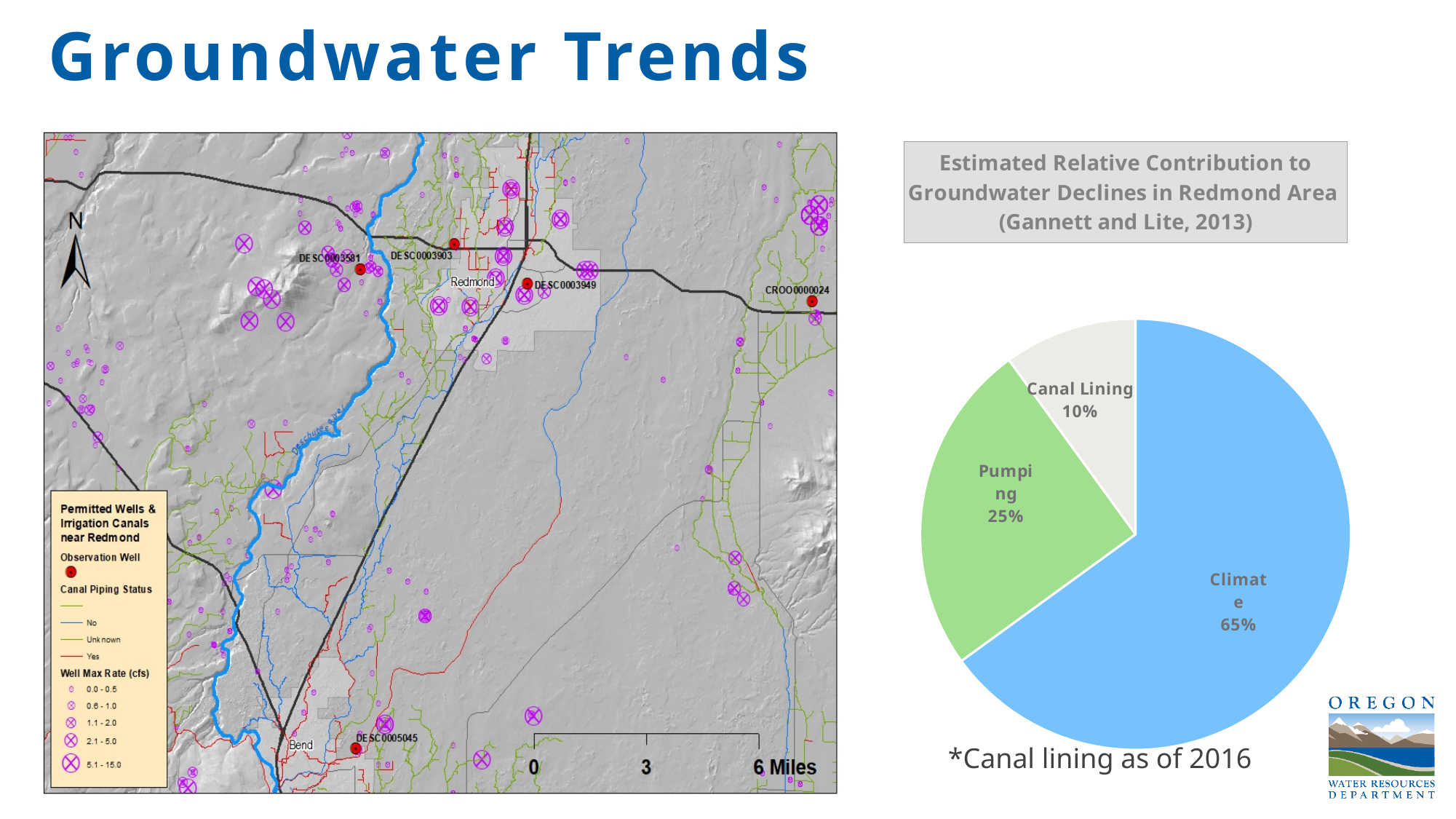
What is the estimated relative contribution of Pumping to groundwater declines in the Redmond area? 25% Which contributes more to groundwater declines according to the pie chart, Pumping or Canal Lining? Pumping Which factor has the largest share in the pie chart? Climate What is the title of the pie chart? Estimated Relative Contribution to Groundwater Declines in Redmond Area (Gannett and Lite, 2013) How many slices does the pie chart have? 3 What kind of chart is shown on the right side of the slide? pie chart What is the difference in percentage points between the Climate and Pumping shares? 40 What is the combined share of Pumping and Canal Lining in the pie chart? 35% Which factor has the smallest share in the pie chart? Canal Lining What colour is the Climate slice in the pie chart? blue What is the estimated relative contribution of Canal Lining to groundwater declines in the Redmond area? 10% What is the estimated relative contribution of Climate to groundwater declines in the Redmond area? 65%